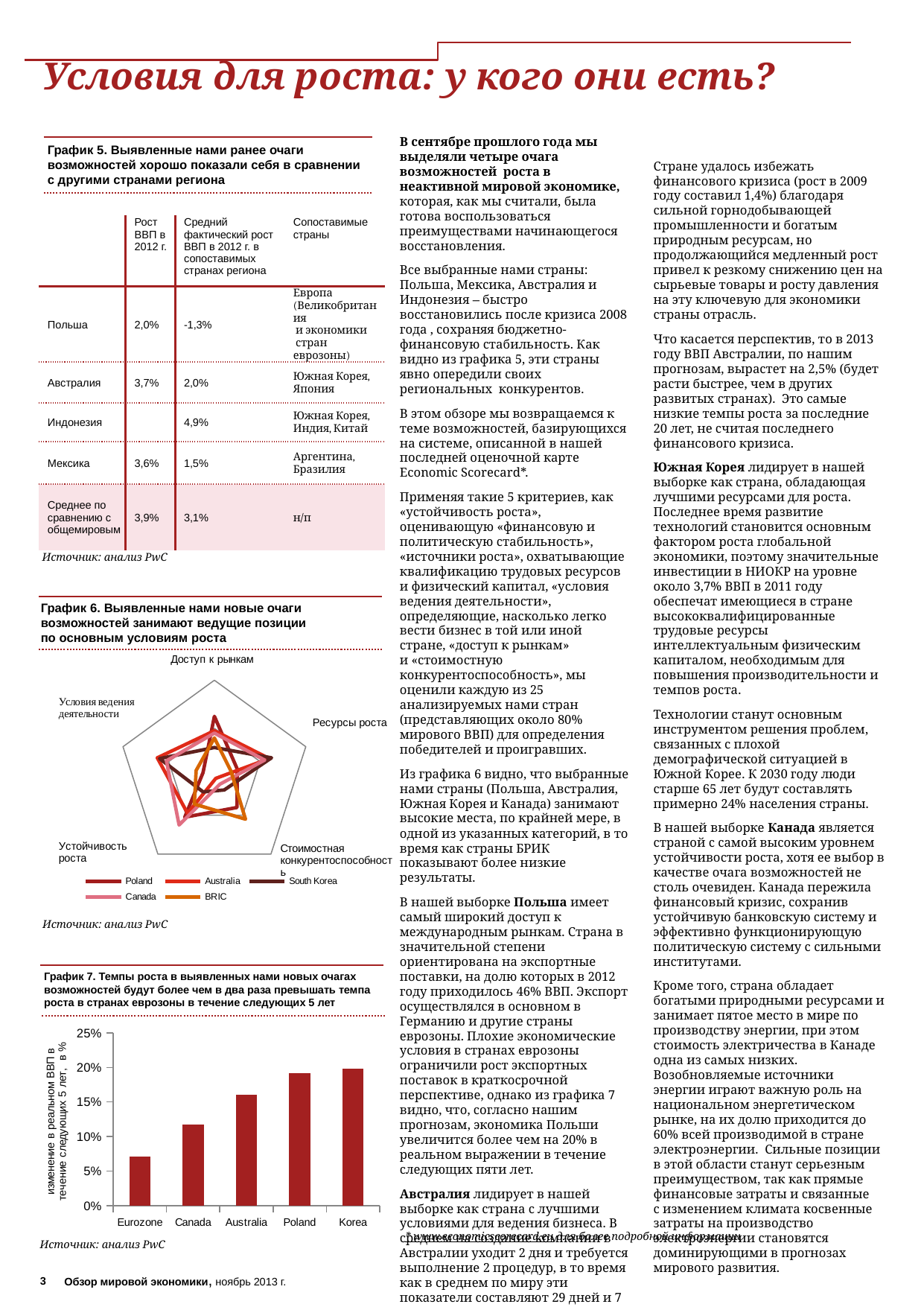
On the chart titled 'График 7', do the values rise or fall moving from Eurozone to Korea along the x axis? rise On the chart titled 'График 7', how many countries/regions are shown on the x axis? 5 On the chart titled 'График 7', is the value for Australia greater or less than 15%? greater On the chart titled 'График 7', is the value for Eurozone greater or less than 10%? less On the chart titled 'График 7', what kind of chart is shown? bar chart On the chart titled 'График 7', which is larger, the value for Australia or the value for Eurozone? Australia On the chart titled 'График 7', is the value for Canada greater or less than 10%? greater On the chart titled 'График 7', which category has the lowest value? Eurozone On the chart titled 'График 6', how many criteria (axes) are plotted? 5 On the chart titled 'График 6', how many series does the legend list? 5 On the chart titled 'График 6', what kind of chart is shown? radar chart